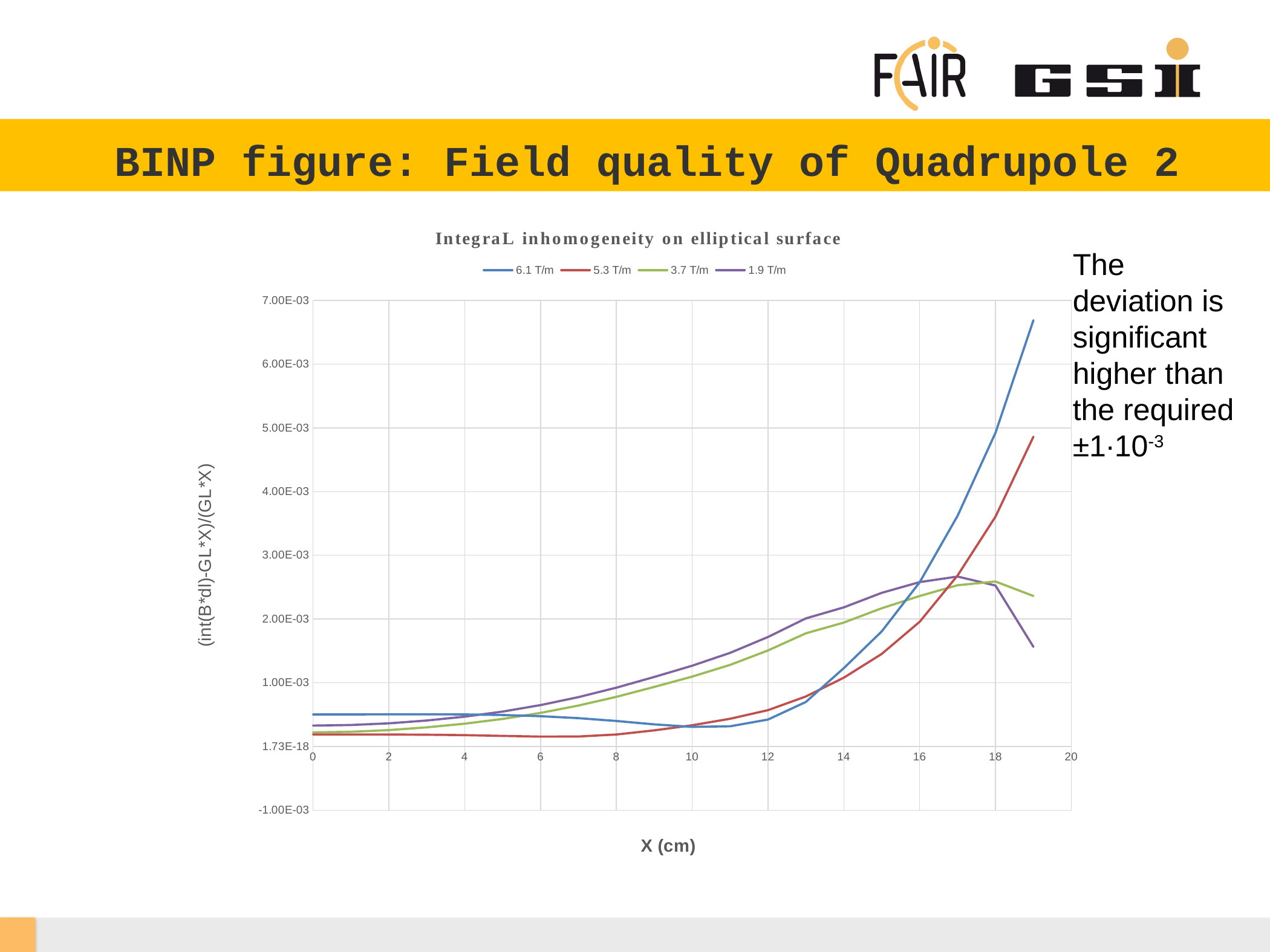
Is the value of the 6.1 T/m series at X = 19 cm greater or less than 6.00E-03? greater At X = 10 cm, which is larger: the 1.9 T/m series or the 6.1 T/m series? 1.9 T/m What kind of chart is shown on the slide? line chart Is the value of the 5.3 T/m series at X = 19 cm greater or less than 4.00E-03? greater Which series reaches the highest value on the chart? 6.1 T/m At X = 19 cm, which is larger: the 6.1 T/m series or the 5.3 T/m series? 6.1 T/m Is the value of the 1.9 T/m series at X = 19 cm greater or less than 2.00E-03? less Does the 1.9 T/m series rise or fall between X = 17 cm and X = 19 cm? fall What is the label of the x axis? X (cm) How many series does the legend list? 4 Which series has the lowest value at X = 19 cm? 1.9 T/m What is the title of the chart? IntegraL inhomogeneity on elliptical surface